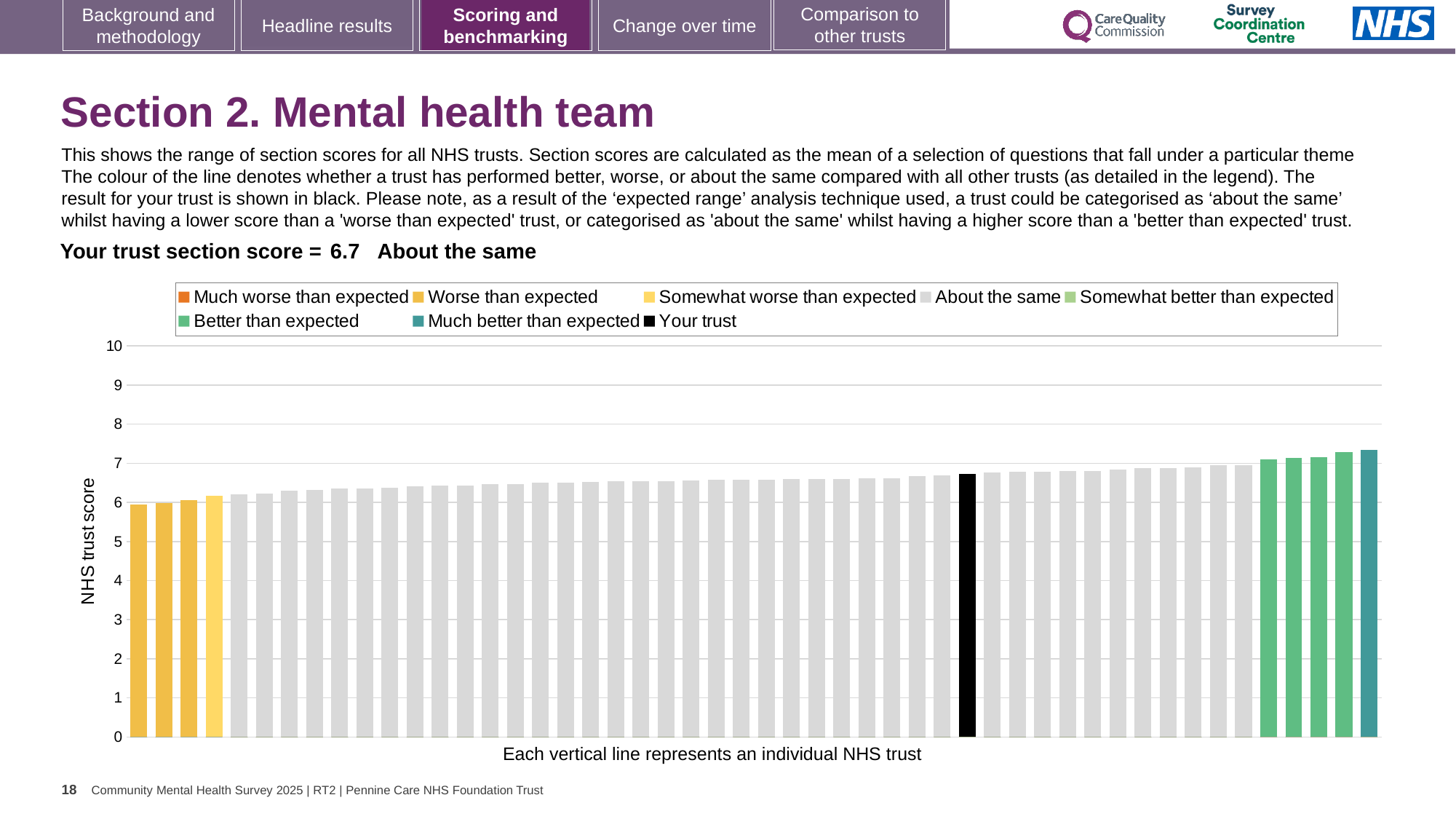
What is the section score for your trust shown on the slide? 6.7 How many bars are coloured as 'Much better than expected' (teal)? 1 Is the highest bar in the chart greater or less than 8? less What kind of chart is shown on the slide? bar chart Which category is your trust placed in according to the text above the chart? About the same What is the label on the vertical axis of the chart? NHS trust score How many bars are coloured as 'Worse than expected' (dark yellow)? 3 Is the value for your trust (the black bar) greater or less than 5? greater How many entries does the chart legend list? 8 Is the lowest bar in the chart greater or less than 5? greater How many bars are coloured as 'Better than expected' (green)? 4 Do the bar values rise or fall from left to right along the x axis? rise